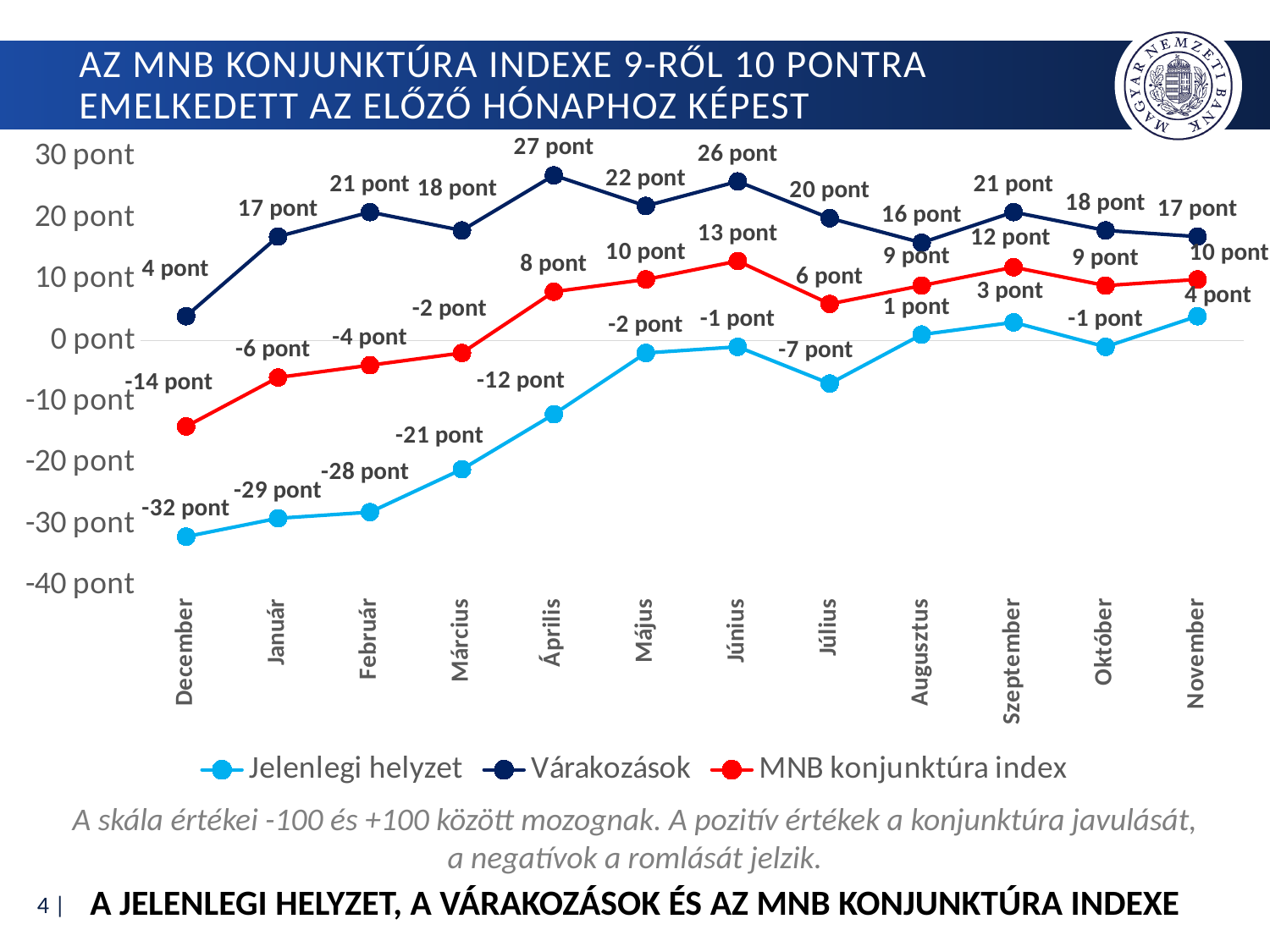
How many months are shown on the x axis? 12 Does Jelenlegi helyzet rise or fall from December to Június? rise In which month is Várakozások highest? Április What kind of chart is shown on the slide? line chart In which month is Jelenlegi helyzet lowest? December Is the value of Jelenlegi helyzet in Március greater or less than -20 pont? less What is the value of Jelenlegi helyzet in December? -32 pont Which is larger in Szeptember: Várakozások or MNB konjunktúra index? Várakozások What is the difference between the MNB konjunktúra index in Június and in Július? 7 pont How many series does the legend list? 3 What is the value of MNB konjunktúra index in November? 10 pont What is the value of Várakozások in Április? 27 pont